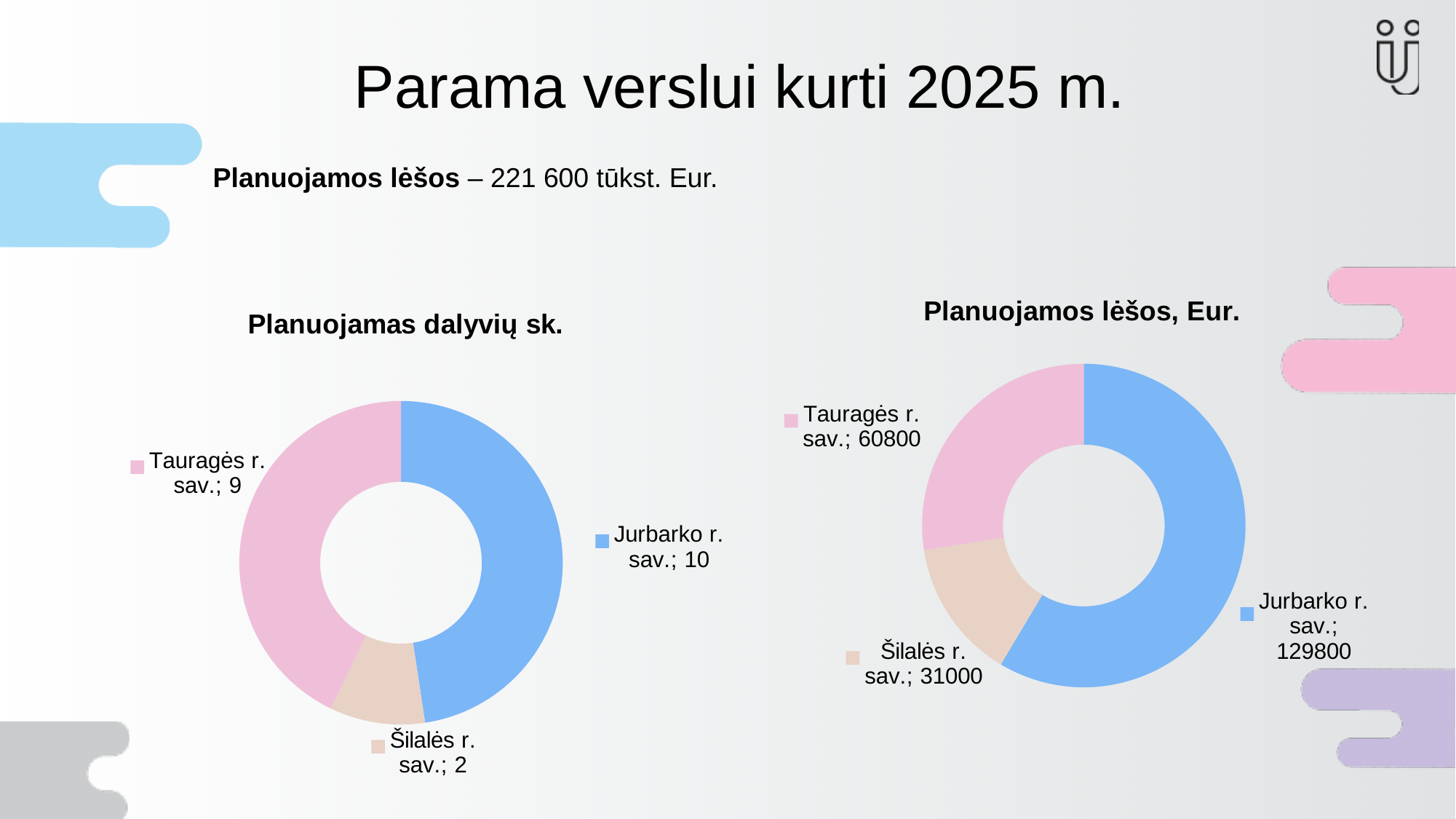
In the 'Planuojamas dalyvių sk.' chart, which category has the lowest value? Šilalės r. sav. In the 'Planuojamos lėšos, Eur.' chart, what is the value for Tauragės r. sav.? 60800 In the 'Planuojamos lėšos, Eur.' chart, what is the value for Jurbarko r. sav.? 129800 In the 'Planuojamas dalyvių sk.' chart, what is the difference between Jurbarko r. sav. and Tauragės r. sav.? 1 What is the total of all values in the 'Planuojamos lėšos, Eur.' chart? 221600 In the 'Planuojamas dalyvių sk.' chart, what is the value for Šilalės r. sav.? 2 What kind of chart is the 'Planuojamos lėšos, Eur.' chart? Doughnut chart In the 'Planuojamos lėšos, Eur.' chart, what is the difference between Jurbarko r. sav. and Tauragės r. sav.? 69000 How many categories does the 'Planuojamas dalyvių sk.' chart show? 3 In the 'Planuojamos lėšos, Eur.' chart, which is larger: Tauragės r. sav. or Šilalės r. sav.? Tauragės r. sav. In the 'Planuojamas dalyvių sk.' chart, what is the value for Jurbarko r. sav.? 10 In the 'Planuojamos lėšos, Eur.' chart, which category has the highest value? Jurbarko r. sav.